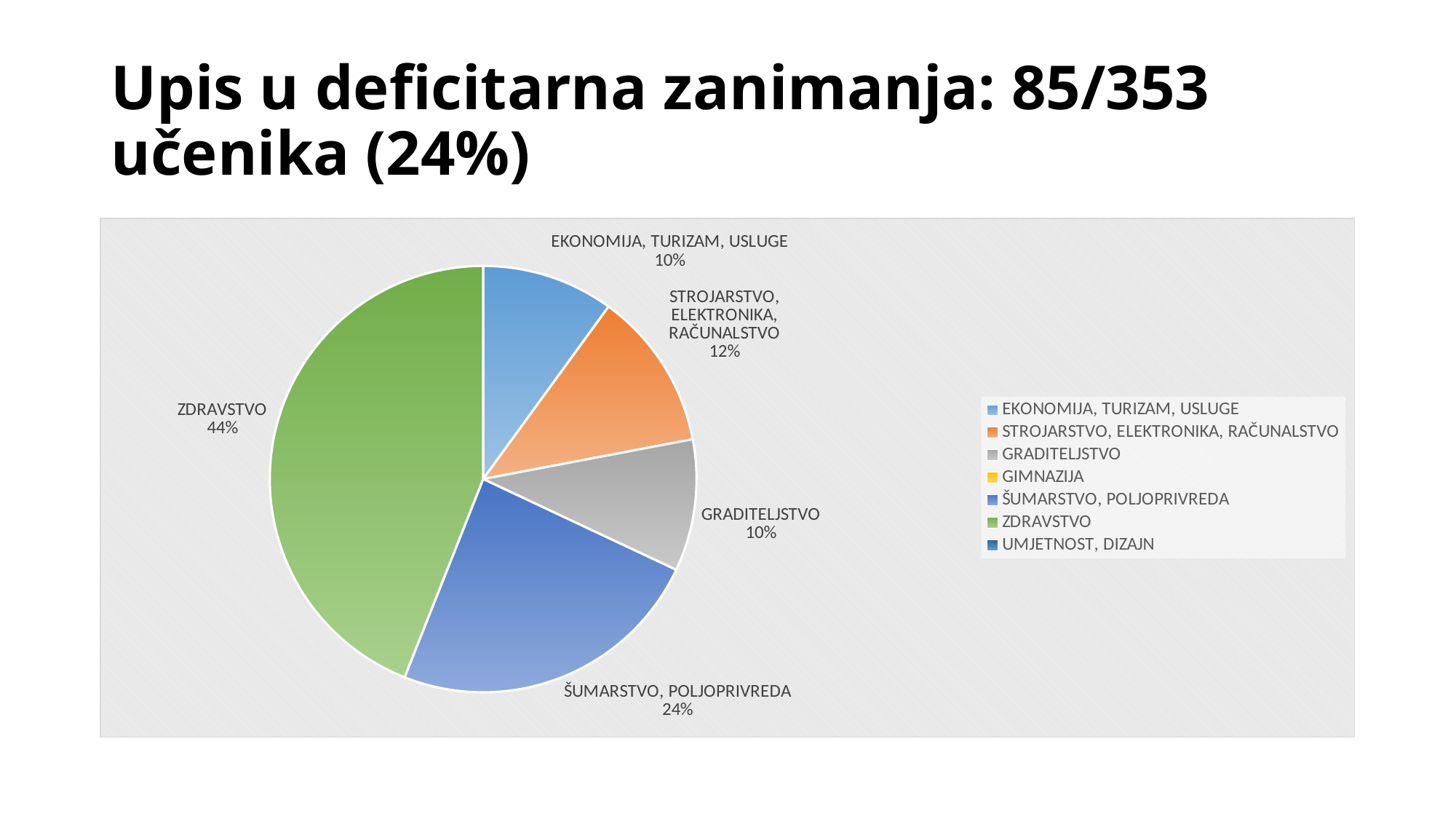
What is the difference in percentage points between ZDRAVSTVO and ŠUMARSTVO, POLJOPRIVREDA? 20 What colour is the ZDRAVSTVO slice? green How many entries does the legend list? 7 What percentage is shown for EKONOMIJA, TURIZAM, USLUGE? 10% Which is larger, the slice for ŠUMARSTVO, POLJOPRIVREDA or the slice for STROJARSTVO, ELEKTRONIKA, RAČUNALSTVO? ŠUMARSTVO, POLJOPRIVREDA What percentage is shown for STROJARSTVO, ELEKTRONIKA, RAČUNALSTVO? 12% What percentage is shown for GRADITELJSTVO? 10% What share of the pie does ZDRAVSTVO have? 44% What share of the pie does ŠUMARSTVO, POLJOPRIVREDA have? 24% What kind of chart is shown on the slide? pie chart Which category has the largest slice of the pie? ZDRAVSTVO What is the difference in percentage points between STROJARSTVO, ELEKTRONIKA, RAČUNALSTVO and GRADITELJSTVO? 2